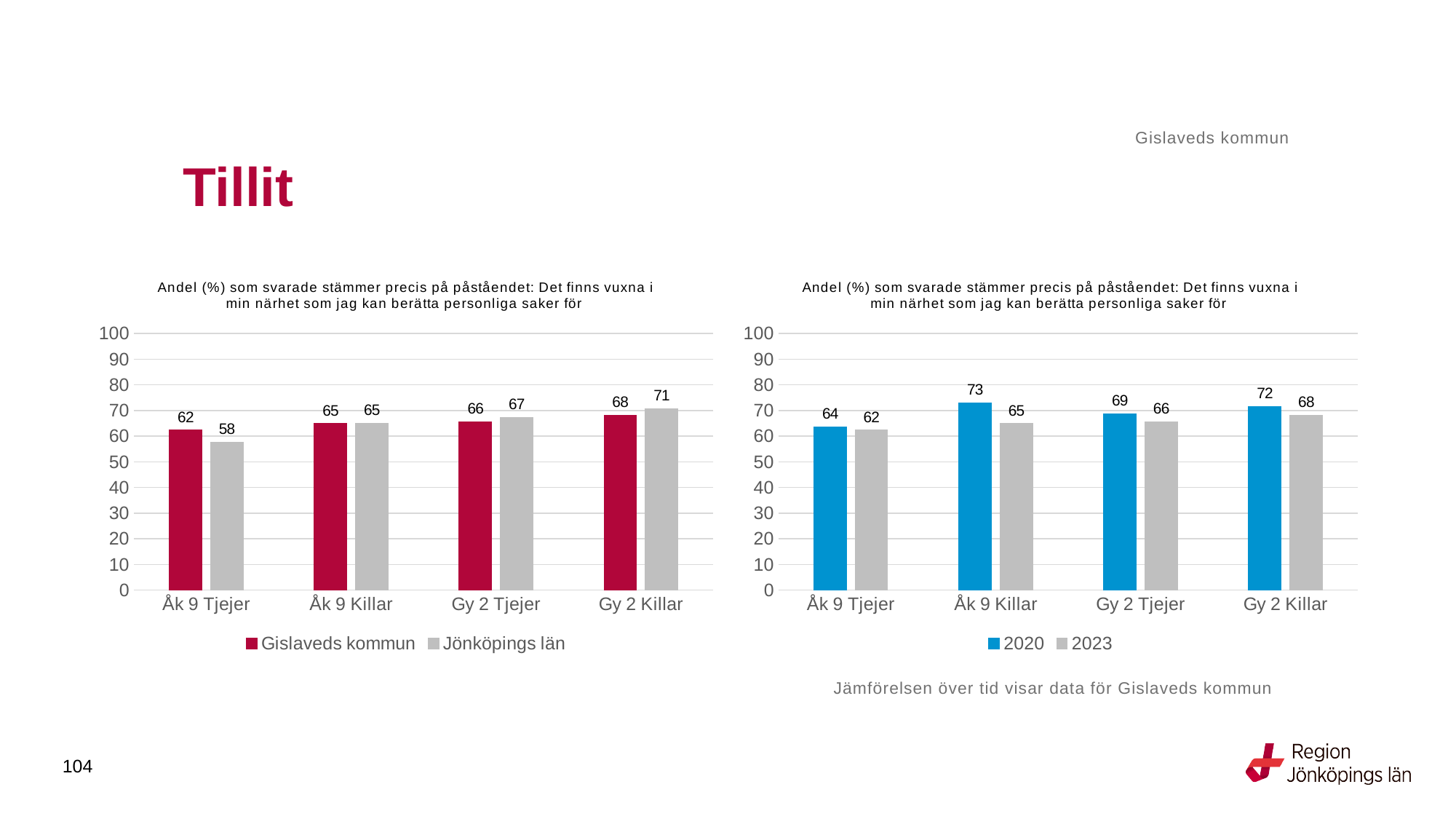
In the left chart, which is larger for Åk 9 Tjejer: Gislaveds kommun or Jönköpings län? Gislaveds kommun In the left chart, what is the value for Jönköpings län for Gy 2 Killar? 71 What type of chart is the right chart? Bar chart In the left chart, what is the difference between Jönköpings län and Gislaveds kommun for Gy 2 Killar? 3 In the right chart, what is the 2023 value for Gy 2 Tjejer? 66 How many categories are shown on the x axis of the right chart? 4 How many series does the legend of the left chart list? 2 In the left chart, which category has the lowest value for Jönköpings län? Åk 9 Tjejer In the right chart, what is the 2020 value for Åk 9 Killar? 73 In the right chart, what is the difference between the 2020 and 2023 values for Åk 9 Killar? 8 In the left chart, what is the value for Gislaveds kommun for Åk 9 Tjejer? 62 In the right chart, which category has the highest 2020 value? Åk 9 Killar